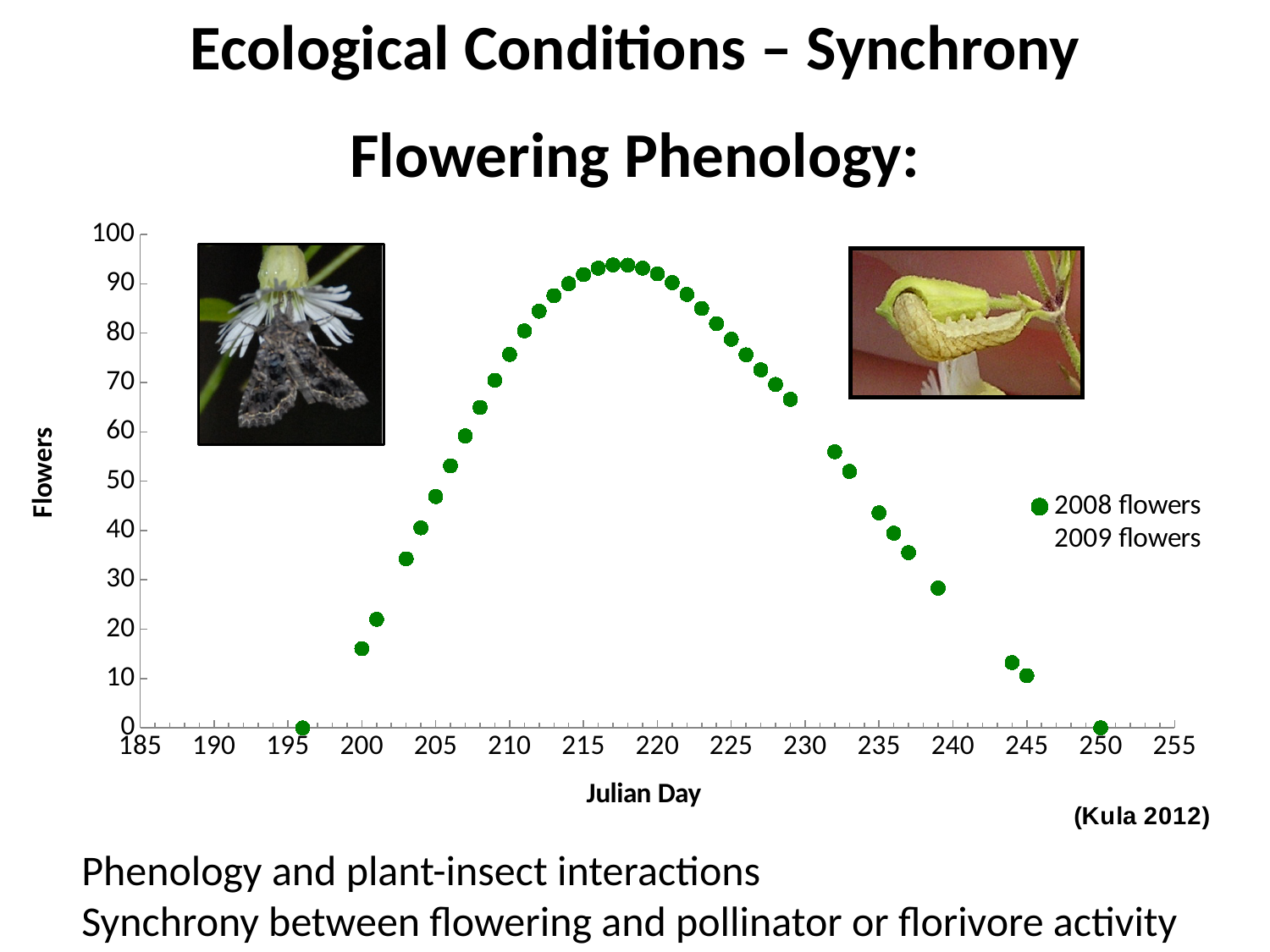
Is the number of flowers at Julian day 200 greater or less than 20? less Between Julian day 196 and Julian day 215, do the flower counts rise or fall? rise Is the number of flowers at Julian day 217 greater or less than 90? greater What is the number of flowers plotted at Julian day 250? 0 Between Julian day 220 and Julian day 250, do the flower counts rise or fall? fall What kind of chart is shown on the slide? scatter chart How many series does the chart legend list? 2 Which has more flowers: Julian day 210 or Julian day 235? Julian day 210 What is the number of flowers plotted at Julian day 196? 0 Is the number of flowers at Julian day 239 greater or less than 30? less What is the title of the chart's x axis? Julian Day What are the two entries in the chart legend? 2008 flowers, 2009 flowers